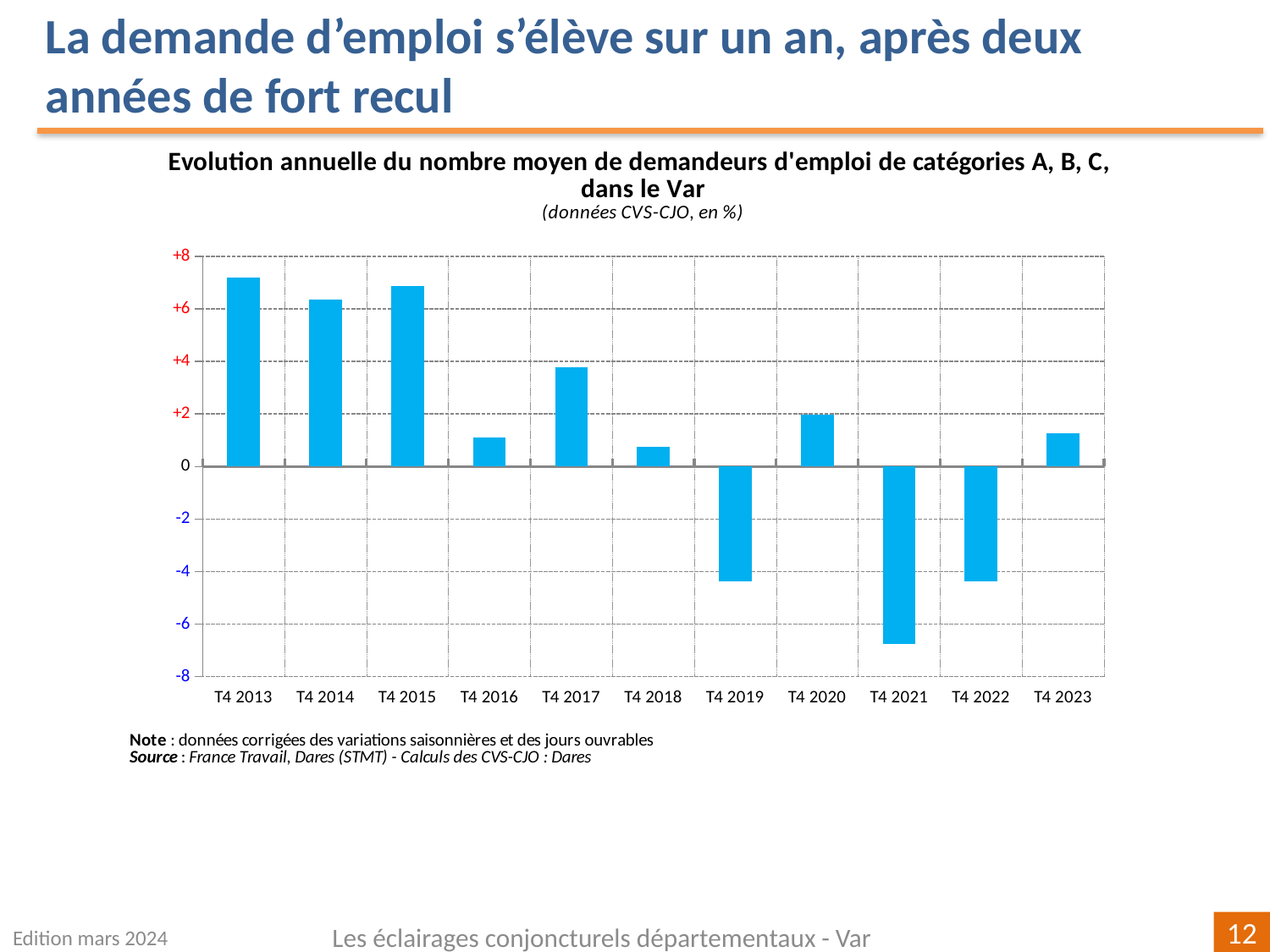
Is the value for T4 2013 greater or less than +6? greater Which is larger, the value for T4 2017 or the value for T4 2018? T4 2017 Which is larger, the value for T4 2015 or the value for T4 2016? T4 2015 Which period has the highest value in the chart? T4 2013 What colour are the bars in the chart? blue Is the value for T4 2016 greater or less than +2? less Is the value for T4 2021 greater or less than -6? less Do the values rise or fall from T4 2013 to T4 2016? fall How many periods (categories) are shown on the x axis of the chart? 11 Which period has the lowest value in the chart? T4 2021 What kind of chart is shown on the slide? bar chart